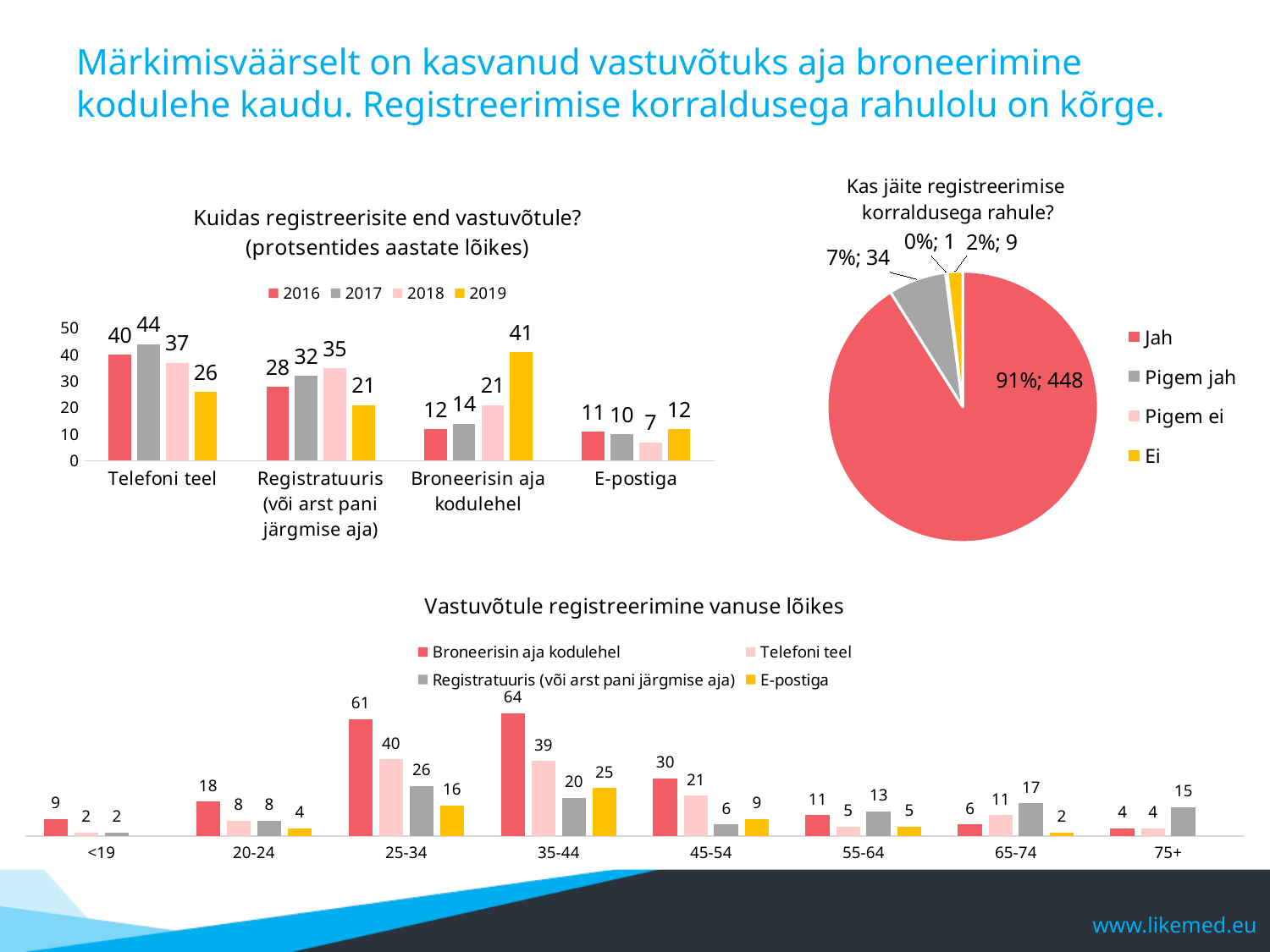
In the chart 'Vastuvõtule registreerimine vanuse lõikes', how many age groups are shown on the x axis? 8 In the chart 'Kuidas registreerisite end vastuvõtule?', what is the value for 'Broneerisin aja kodulehel' in 2019? 41 In the pie chart 'Kas jäite registreerimise korraldusega rahule?', what is the count shown for 'Pigem jah'? 34 In the chart 'Kuidas registreerisite end vastuvõtule?', how many series does the legend list? 4 What kind of chart is 'Kas jäite registreerimise korraldusega rahule?'? pie chart In the chart 'Vastuvõtule registreerimine vanuse lõikes', which age group has the highest value for 'Telefoni teel'? 25-34 In the chart 'Kuidas registreerisite end vastuvõtule?', do the values for 'Telefoni teel' rise or fall from 2017 to 2019? fall In the chart 'Vastuvõtule registreerimine vanuse lõikes', what is the value for 'Broneerisin aja kodulehel' in the 35-44 age group? 64 In the pie chart 'Kas jäite registreerimise korraldusega rahule?', what share does 'Jah' have? 91% In the chart 'Kuidas registreerisite end vastuvõtule?', what is the value for 'Telefoni teel' in 2017? 44 In the chart 'Kuidas registreerisite end vastuvõtule?', what is the difference between the 2019 and 2018 values for 'Broneerisin aja kodulehel'? 20 In the chart 'Kuidas registreerisite end vastuvõtule?', which category has the lowest value in 2018? E-postiga